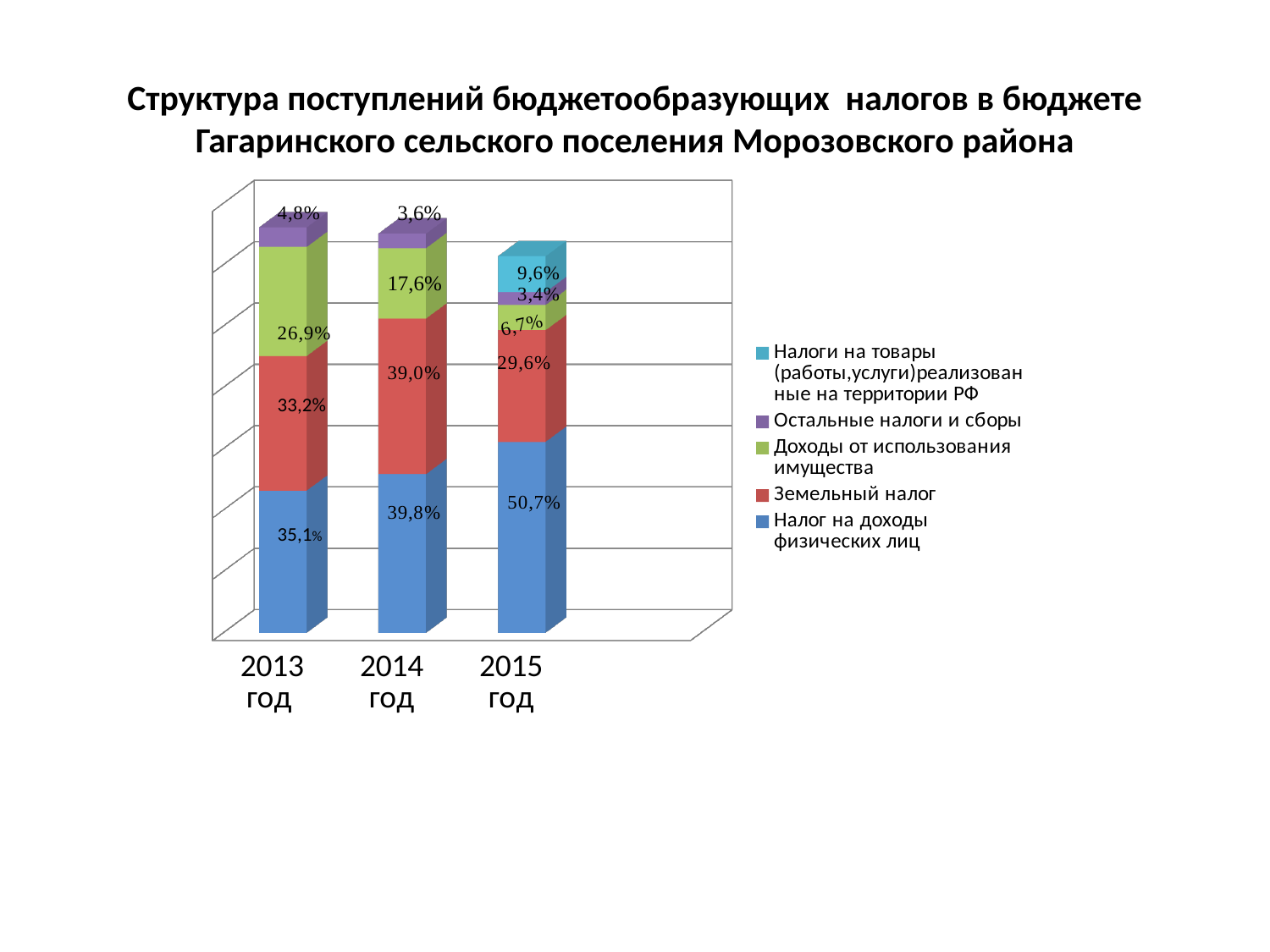
Which is larger in 2013 год: Земельный налог or Доходы от использования имущества? Земельный налог By how much did the share of Налог на доходы физических лиц in 2015 год exceed that in 2013 год? 15,6% In which year is the share of Налог на доходы физических лиц the highest? 2015 год What is the value of Доходы от использования имущества for 2015 год? 6,7% What is the value of Земельный налог for 2014 год? 39,0% What kind of chart is shown on the slide? Stacked bar chart In which year is the share of Остальные налоги и сборы the lowest? 2015 год What is the value of Налоги на товары (работы,услуги) реализованные на территории РФ in 2015 год? 9,6% What share does Налог на доходы физических лиц have in 2013 год? 35,1% How many years are shown on the x axis? 3 Does the share of Доходы от использования имущества rise or fall from 2013 год to 2015 год? Fall How many series does the legend list? 5